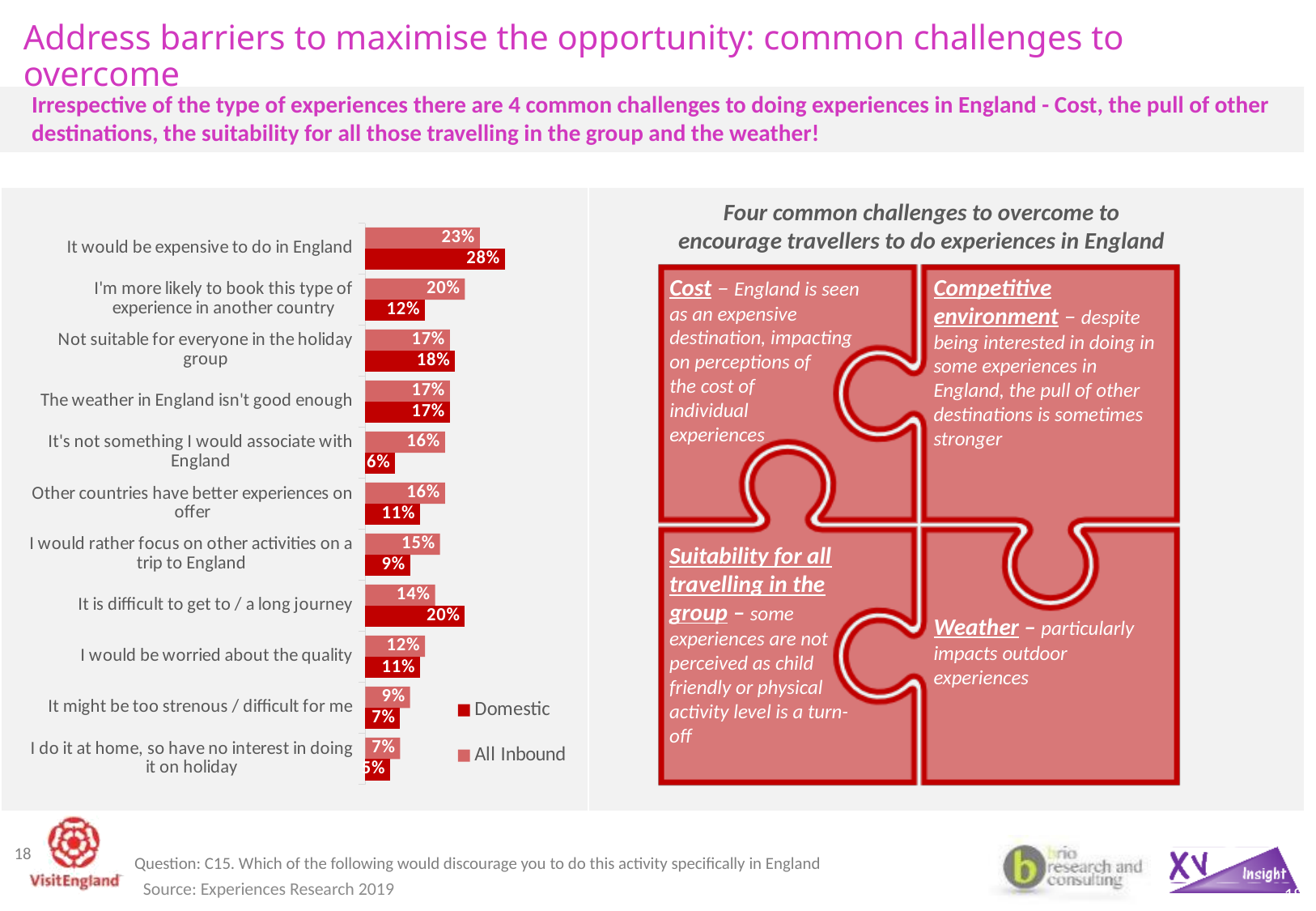
Which series is shown in the darker red colour in the chart? Domestic What is the Domestic value for "It's not something I would associate with England"? 6% Which category has the lowest All Inbound value? I do it at home, so have no interest in doing it on holiday What is the All Inbound value for "It would be expensive to do in England"? 23% How many series does the chart legend list? 2 What is the Domestic value for "It is difficult to get to / a long journey"? 20% What is the difference between the Domestic and All Inbound values for "I'm more likely to book this type of experience in another country"? 8% For "Other countries have better experiences on offer", which series has the larger value, Domestic or All Inbound? All Inbound How many categories are shown in the bar chart? 11 Which category has the highest Domestic value? It would be expensive to do in England What type of chart is shown on the slide? Bar chart What is the difference between the Domestic and All Inbound values for "It would be expensive to do in England"? 5%